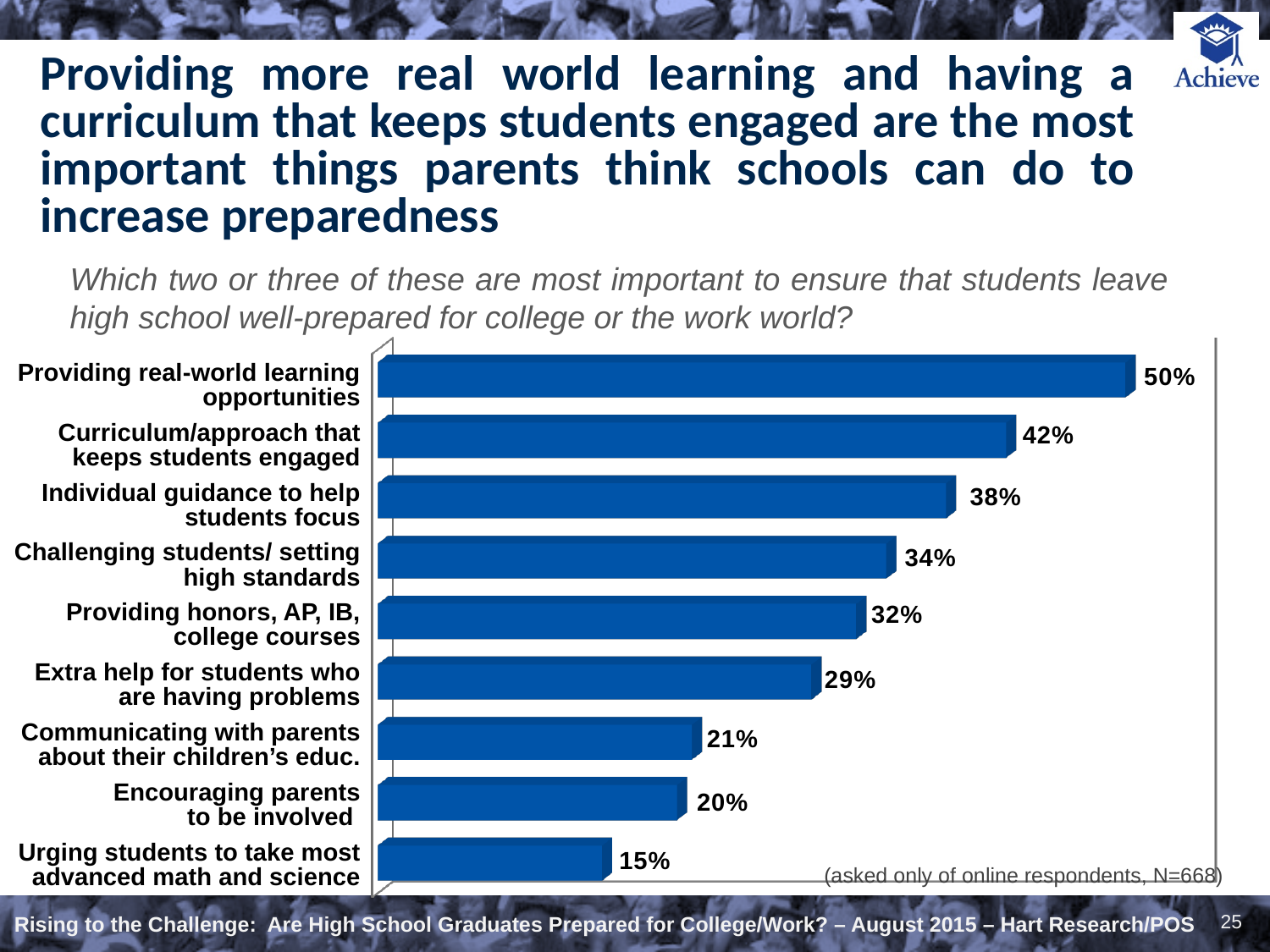
What kind of chart is shown on the slide? Bar chart According to the note on the chart, how many online respondents were asked this question? N=668 What is the difference between 'Challenging students/ setting high standards' and 'Providing honors, AP, IB, college courses'? 2% Which is larger: 'Extra help for students who are having problems' or 'Communicating with parents about their children's educ.'? Extra help for students who are having problems Which category has the lowest value? Urging students to take most advanced math and science What percentage selected 'Encouraging parents to be involved'? 20% Which category has the highest value? Providing real-world learning opportunities What is the difference between 'Providing real-world learning opportunities' and 'Curriculum/approach that keeps students engaged'? 8% Do the values increase or decrease going from the top bar to the bottom bar? Decrease How many categories are shown in the chart? 9 What percentage of parents chose providing real-world learning opportunities? 50% What is the value for 'Individual guidance to help students focus'? 38%